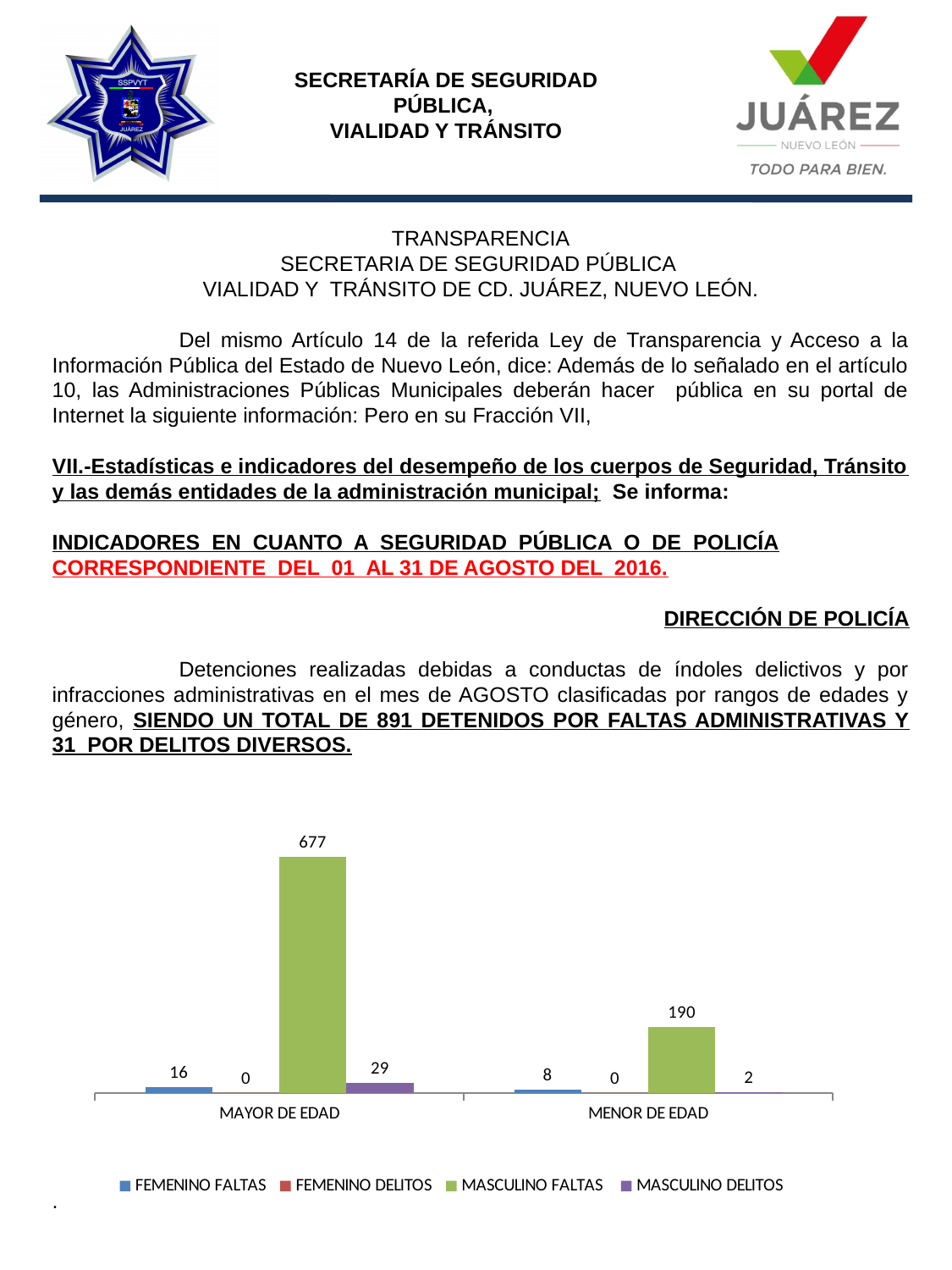
Which is larger: FEMENINO FALTAS for MAYOR DE EDAD or MASCULINO DELITOS for MAYOR DE EDAD? MASCULINO DELITOS for MAYOR DE EDAD What is the value for FEMENINO FALTAS in the MENOR DE EDAD category? 8 How many categories are shown on the x axis of the chart? 2 What is the value for MASCULINO FALTAS in the MAYOR DE EDAD category? 677 What is the value for MASCULINO DELITOS in the MAYOR DE EDAD category? 29 Which series has the highest value in the MENOR DE EDAD category? MASCULINO FALTAS What kind of chart is shown on the slide? Bar chart What is the value for FEMENINO DELITOS in the MENOR DE EDAD category? 0 What is the difference between MASCULINO DELITOS for MAYOR DE EDAD and MASCULINO DELITOS for MENOR DE EDAD? 27 How many series does the chart legend list? 4 Which series is shown in green in the chart legend? MASCULINO FALTAS What is the difference between MASCULINO FALTAS for MAYOR DE EDAD and MASCULINO FALTAS for MENOR DE EDAD? 487